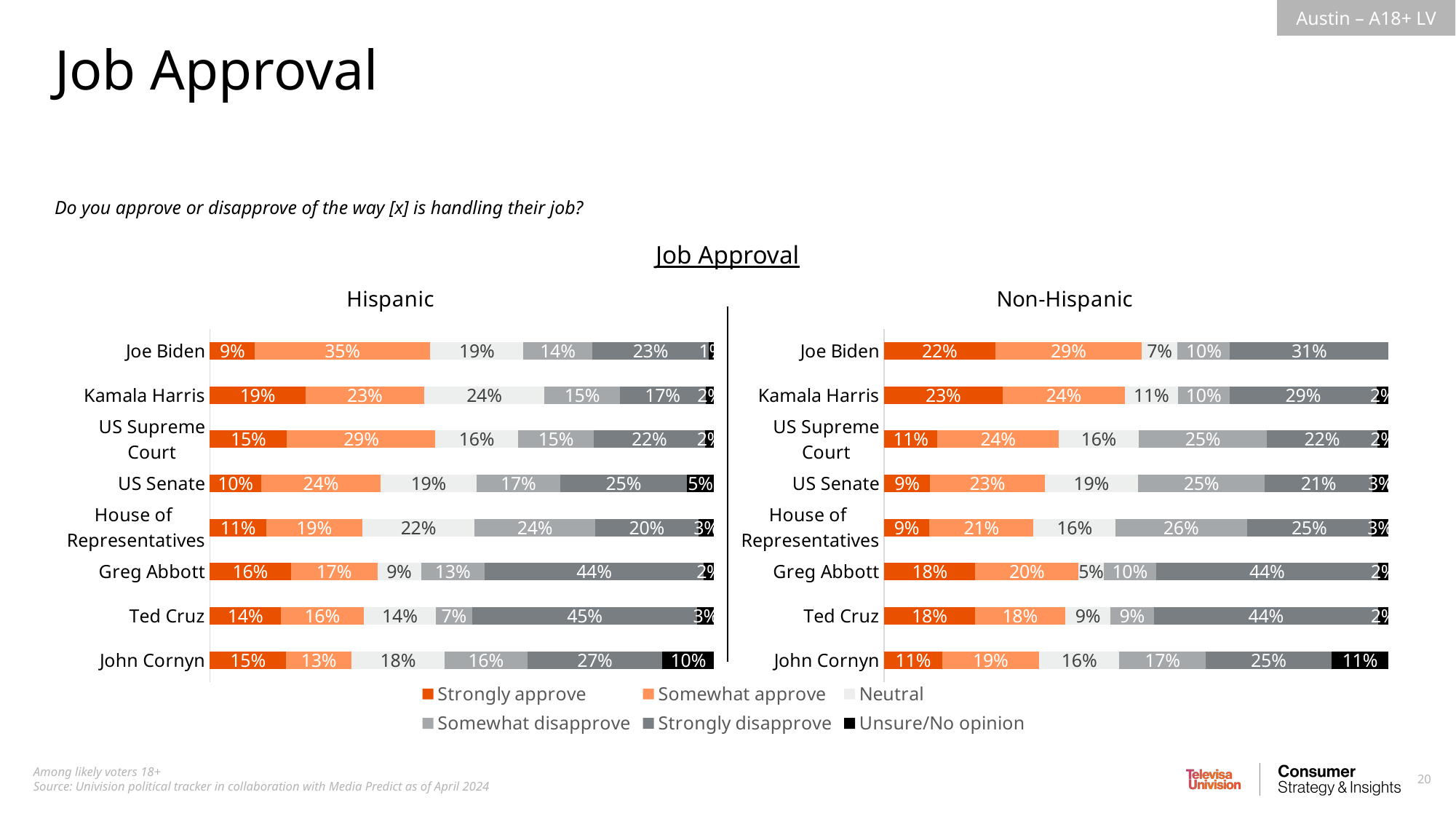
In the Non-Hispanic chart, is the Somewhat disapprove value larger for the House of Representatives or for Ted Cruz? House of Representatives In the Hispanic chart, what percentage of respondents somewhat approve of Joe Biden? 35% In the Hispanic chart, what is the Unsure/No opinion share for John Cornyn? 10% How many categories are shown in the Hispanic chart? 8 In the Non-Hispanic chart, what percentage strongly disapprove of Greg Abbott? 44% What is the title shown above the two charts? Job Approval In the Non-Hispanic chart, which category has the highest Strongly approve value? Kamala Harris In the Non-Hispanic chart, what is the combined Strongly approve and Somewhat approve share for Joe Biden? 51% In the Hispanic chart, what is the difference between the Strongly disapprove values for Ted Cruz and John Cornyn? 18% What kind of chart is used for the Hispanic and Non-Hispanic data? Stacked bar chart How many series does the legend list? 6 In the Hispanic chart, which category has the lowest Strongly approve value? Joe Biden